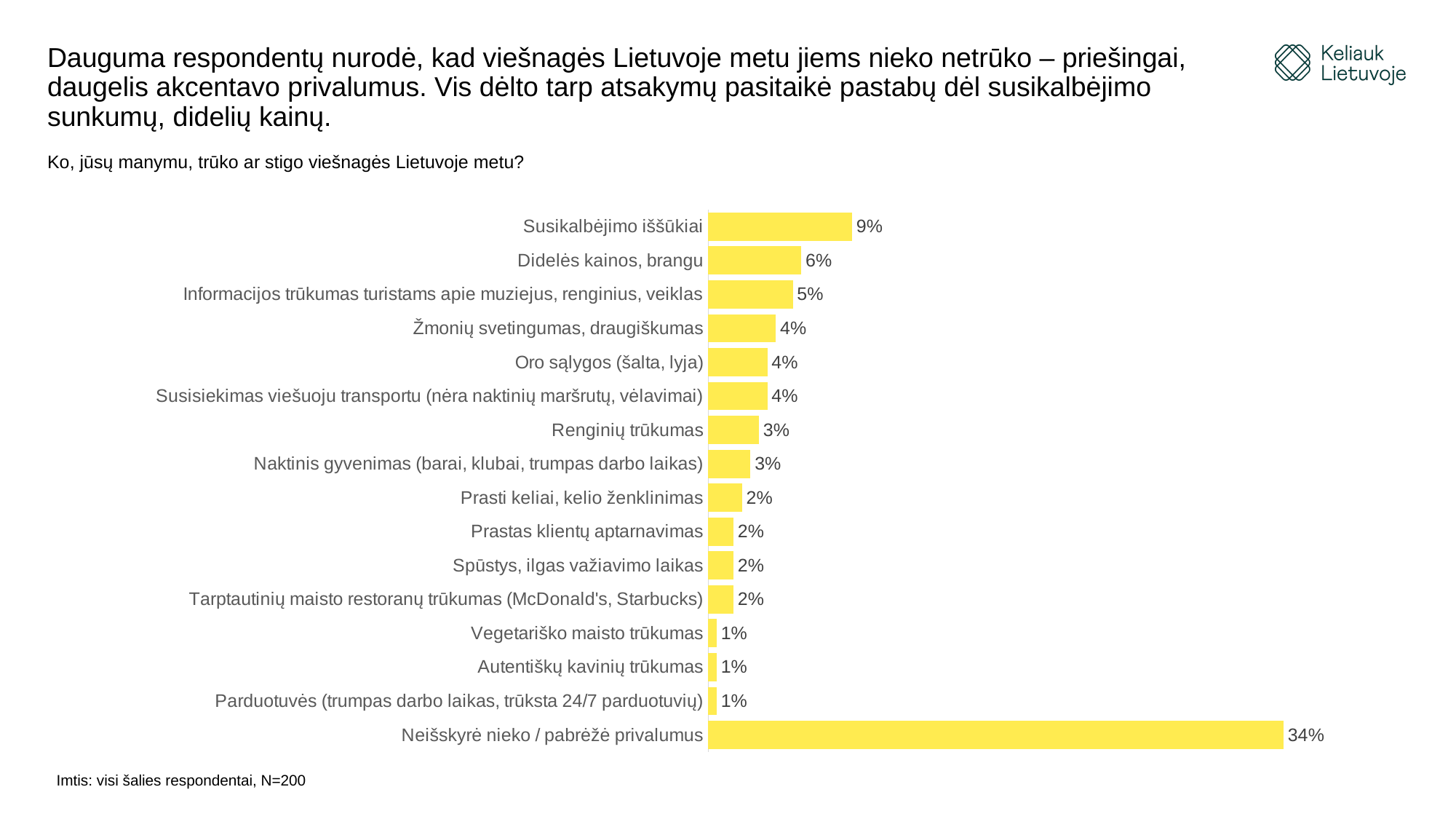
What percentage is shown for "Informacijos trūkumas turistams apie muziejus, renginius, veiklas"? 5% What is the value shown for "Didelės kainos, brangu"? 6% Which category has the highest value in the chart? Neišskyrė nieko / pabrėžė privalumus What is the value shown for "Vegetariško maisto trūkumas"? 1% What percentage of respondents mentioned "Susikalbėjimo iššūkiai"? 9% What is the difference between the values for "Neišskyrė nieko / pabrėžė privalumus" and "Susikalbėjimo iššūkiai"? 25% What is the value for "Neišskyrė nieko / pabrėžė privalumus"? 34% How many categories are shown in the chart? 16 What kind of chart is shown on the slide? Bar chart What is the difference between "Susikalbėjimo iššūkiai" and "Didelės kainos, brangu"? 3% Which is larger: the value for "Renginių trūkumas" or the value for "Oro sąlygos (šalta, lyja)"? Oro sąlygos (šalta, lyja) What question is the chart based on, as written above it? Ko, jūsų manymu, trūko ar stigo viešnagės Lietuvoje metu?